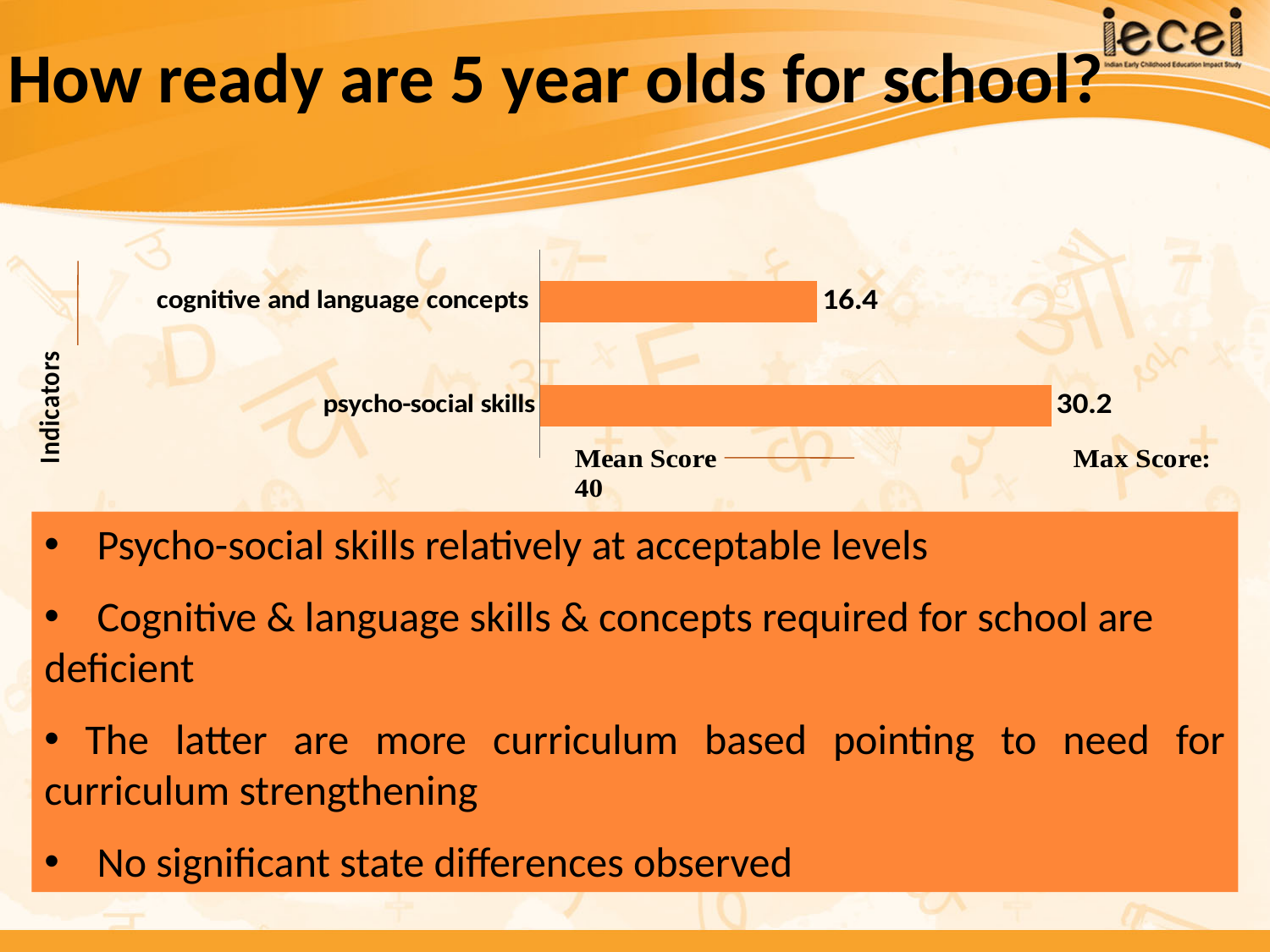
Which indicator has the highest mean score? psycho-social skills What kind of chart is shown on the slide? bar chart Which indicator has the lowest mean score? cognitive and language concepts What is the maximum possible score noted on the chart's axis? 40 Which is larger: the mean score for psycho-social skills or for cognitive and language concepts? psycho-social skills What is the mean score for psycho-social skills? 30.2 How many indicators are plotted in the chart? 2 What is the label on the vertical axis of the chart? Indicators What is the mean score for cognitive and language concepts? 16.4 What is the difference between the mean scores for psycho-social skills and cognitive and language concepts? 13.8